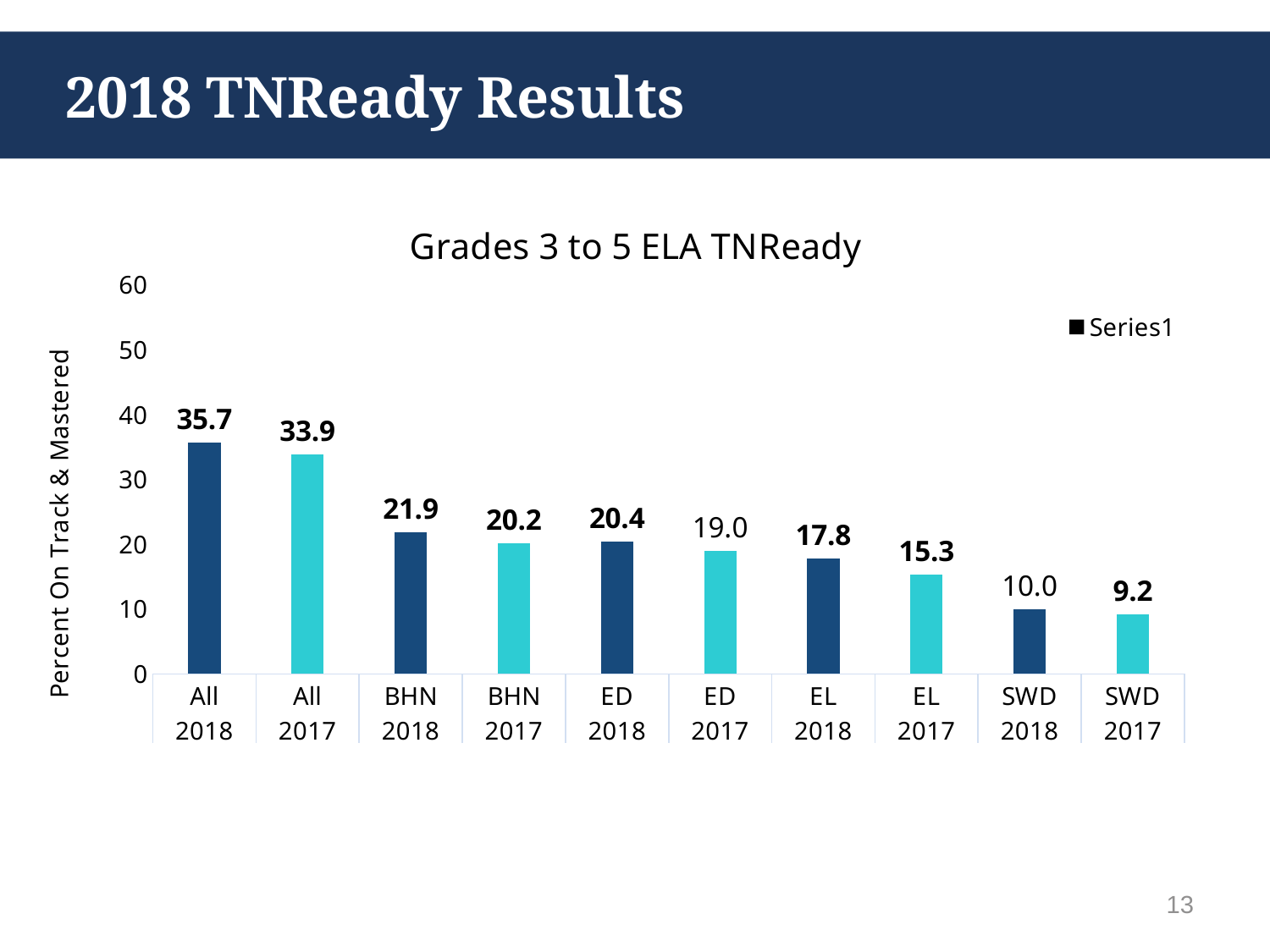
What is the value for SWD 2017? 9.2 What kind of chart is this? bar chart How many categories are shown on the x axis? 10 What is the value for ED 2017? 19.0 Which category has the highest value? All 2018 What is the value for All 2018? 35.7 Which category has the lowest value? SWD 2017 Is the value for SWD 2018 greater or less than 20? less What is the title of the chart? Grades 3 to 5 ELA TNReady Which is larger, BHN 2018 or BHN 2017? BHN 2018 What is the difference between EL 2018 and EL 2017? 2.5 What is the difference between All 2018 and All 2017? 1.8